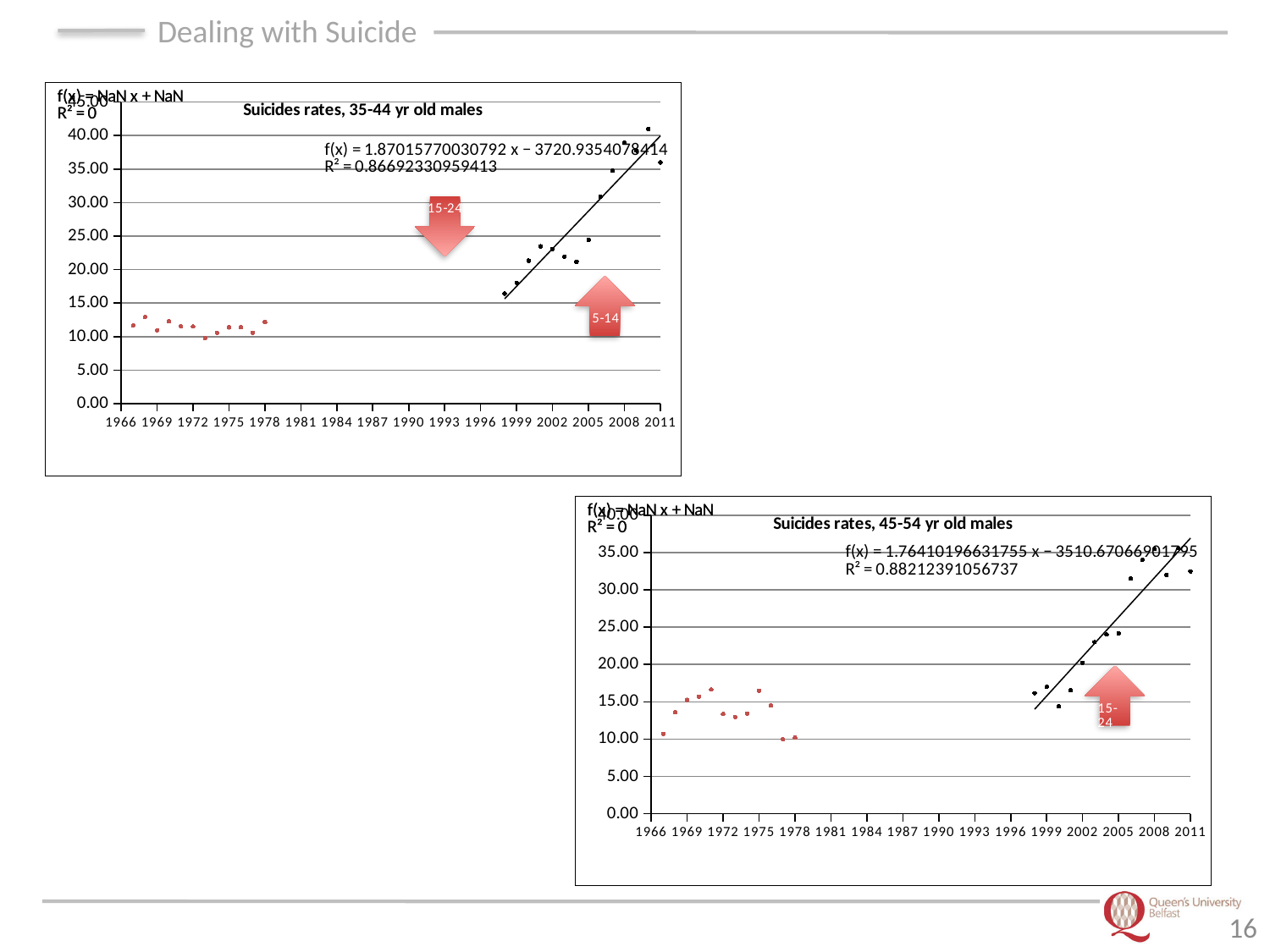
In the 'Suicides rates, 45-54 yr old males' chart, do the values rise or fall across the years from 1998 to 2011? rise In the 'Suicides rates, 45-54 yr old males' chart, is the value for 2011 greater or less than 30.00? greater What is the highest value shown on the y axis of the 'Suicides rates, 45-54 yr old males' chart? 40.00 In the 'Suicides rates, 35-44 yr old males' chart, which year has the larger value, 1970 or 2008? 2008 In the 'Suicides rates, 35-44 yr old males' chart, is the value for 1967 greater or less than 15.00? less In the 'Suicides rates, 35-44 yr old males' chart, what R² value is printed for the fitted trend line on the later data points? 0.86692330959413 In the 'Suicides rates, 35-44 yr old males' chart, is the value for 2008 greater or less than 30.00? greater What is the title of the bottom-right chart? Suicides rates, 45-54 yr old males In the 'Suicides rates, 35-44 yr old males' chart, do the values rise or fall across the years from 1998 to 2011? rise What kind of chart is the top chart titled 'Suicides rates, 35-44 yr old males'? scatter chart In the 'Suicides rates, 45-54 yr old males' chart, what R² value is printed for the fitted trend line on the later data points? 0.88212391056737